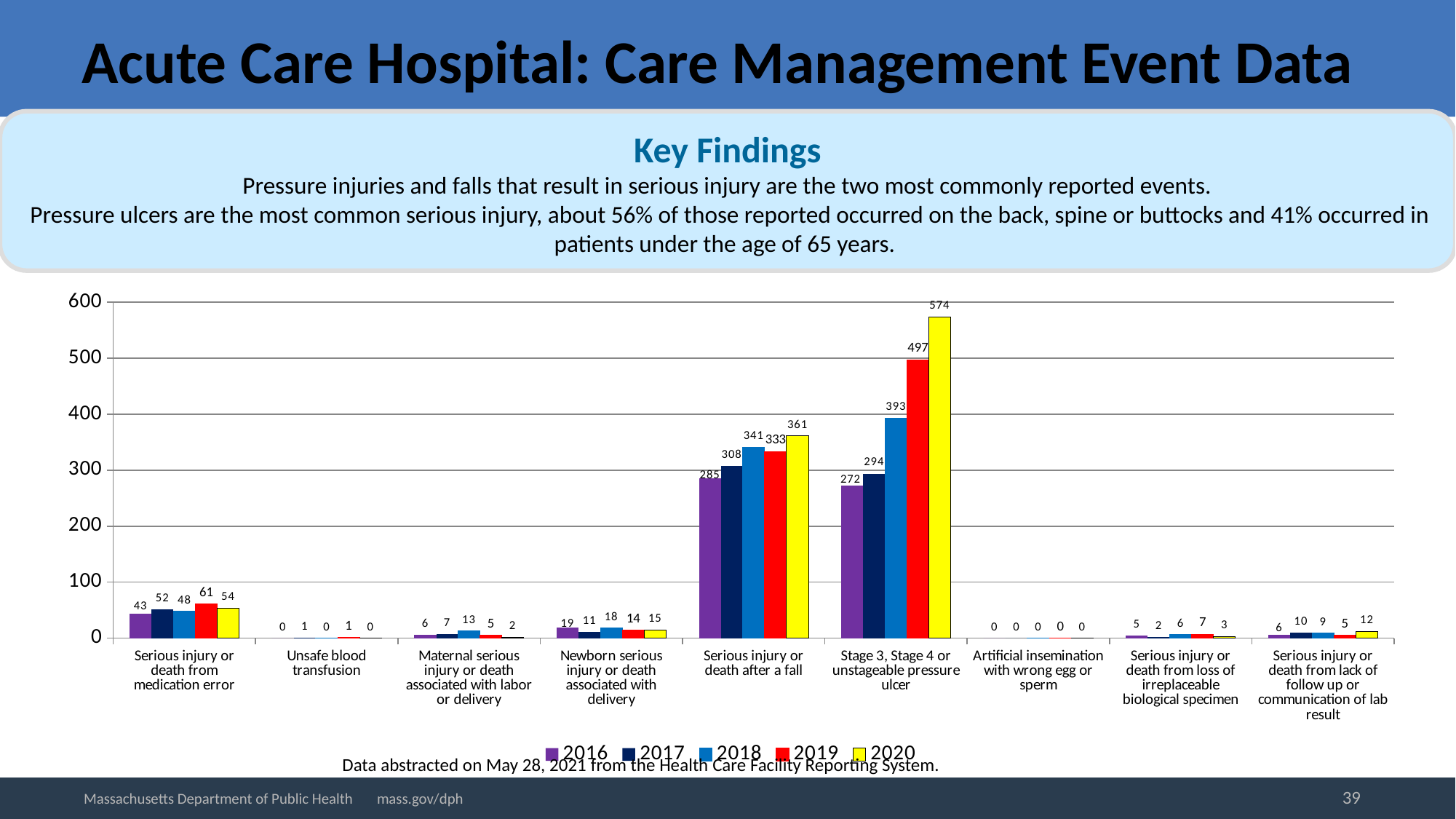
What is the difference between the 2020 and 2019 values for Stage 3, Stage 4 or unstageable pressure ulcer? 77 Which is larger: the 2018 value for Serious injury or death after a fall or the 2018 value for Stage 3, Stage 4 or unstageable pressure ulcer? Stage 3, Stage 4 or unstageable pressure ulcer What is the 2020 value for Stage 3, Stage 4 or unstageable pressure ulcer? 574 Do the values for Stage 3, Stage 4 or unstageable pressure ulcer rise or fall from 2016 to 2020? rise Which category has the highest 2020 value? Stage 3, Stage 4 or unstageable pressure ulcer What is the 2016 value for Serious injury or death after a fall? 285 What is the 2019 value for Serious injury or death from medication error? 61 What kind of chart is shown on the slide? bar chart How many series does the legend list? 5 Which category has the lowest values across all years? Artificial insemination with wrong egg or sperm Is the 2017 value for Serious injury or death after a fall greater or less than 300? greater How many event categories are shown on the x axis? 9